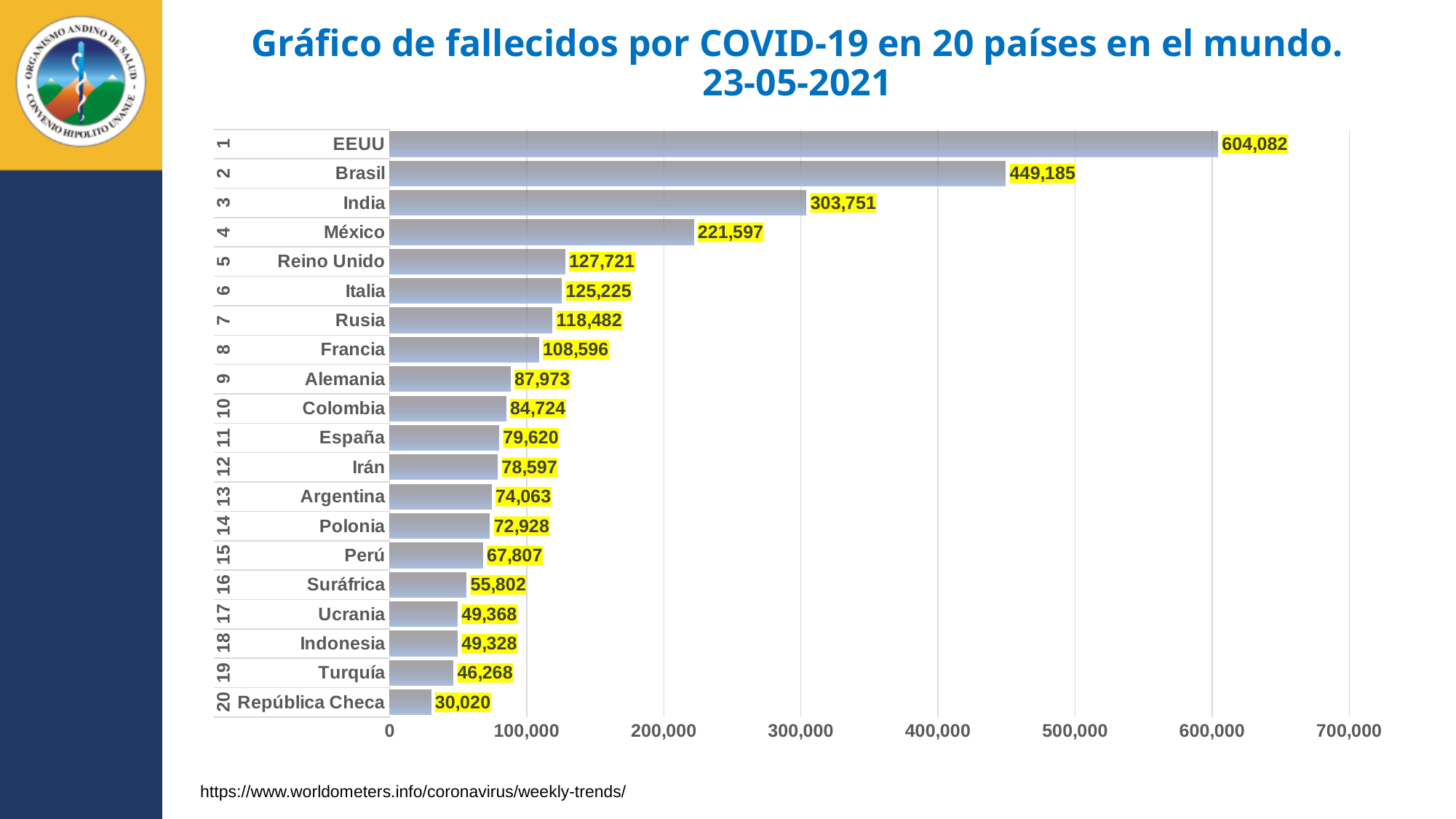
Which country has the lowest number of deaths on the chart? República Checa What is the difference between the values for EEUU and Brasil? 154,897 What is the number of COVID-19 deaths shown for Brasil? 449,185 Which country has the highest number of deaths on the chart? EEUU Is the value for México greater or less than 200,000? greater What value is shown for Perú? 67,807 Which has a larger value, Colombia or Alemania? Alemania What value is shown for Reino Unido? 127,721 What is the difference between the values for India and México? 82,154 How many countries are shown on the chart? 20 What kind of chart is shown on the slide? Bar chart What is the date shown in the chart title? 23-05-2021